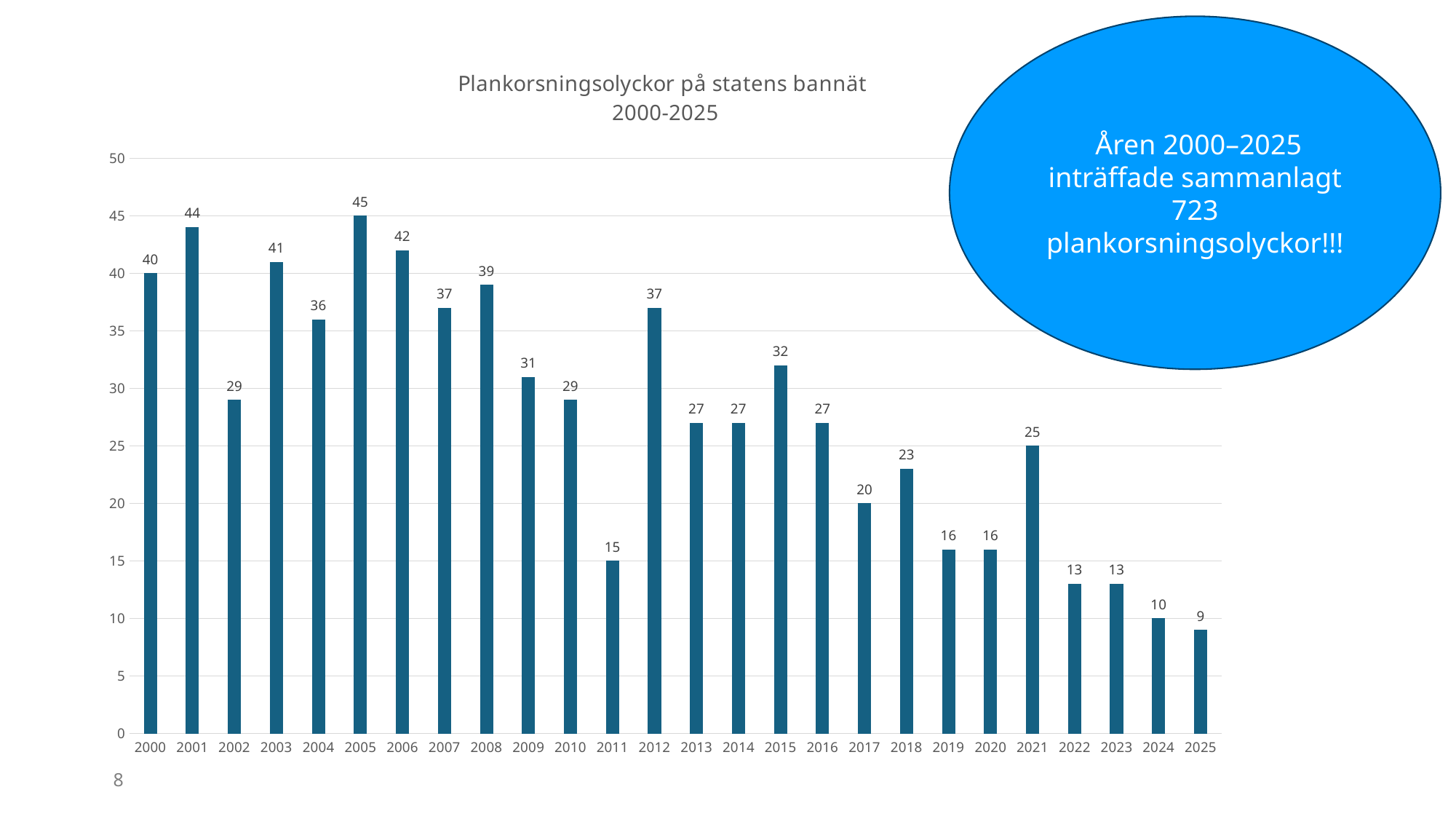
What is the title of the chart? Plankorsningsolyckor på statens bannät 2000-2025 What is the difference between the values for 2000 and 2025? 31 What is the value for 2021? 25 How many years are shown on the x axis? 26 What is the value for 2011? 15 Is the value for 2018 greater or less than 20? greater Which year has the highest value? 2005 Which is larger, the value for 2012 or the value for 2015? 2012 Do the values generally rise or fall from 2000 to 2025? fall What kind of chart is this? bar chart What is the value for 2005? 45 Which year has the lowest value? 2025